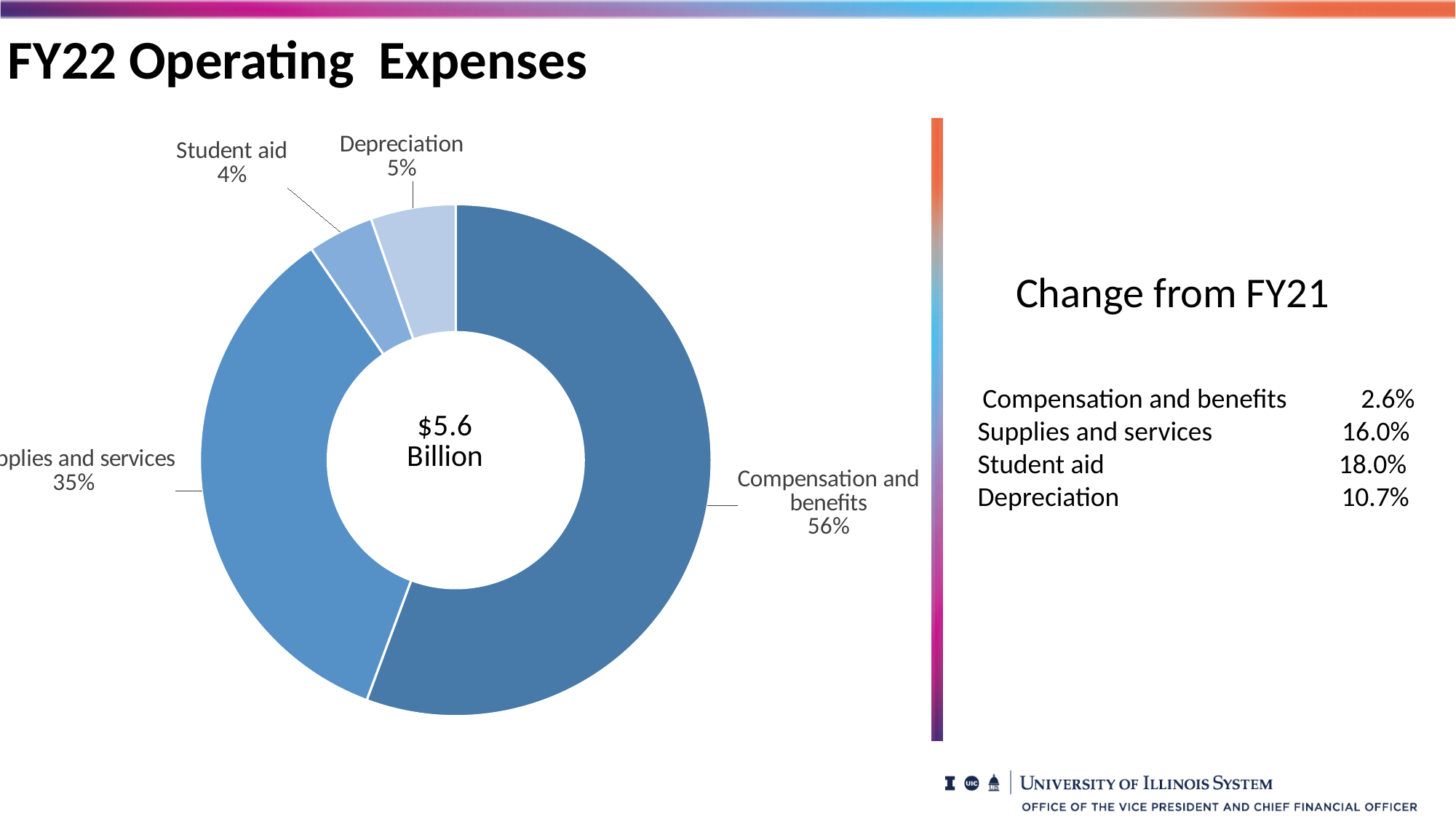
What share of FY22 operating expenses is Compensation and benefits? 56% What share of FY22 operating expenses is Supplies and services? 35% What total amount is shown in the center of the donut chart? $5.6 Billion How many categories are shown in the donut chart? 4 Which is larger, the Depreciation share or the Student aid share? Depreciation How many percentage points larger is the Compensation and benefits share than the Supplies and services share? 21 Which category has the largest share of FY22 operating expenses? Compensation and benefits What percentage of the donut chart is Depreciation? 5% Which category has the smallest share of FY22 operating expenses? Student aid What kind of chart is used to show FY22 operating expenses? Donut (pie) chart What is the title of the slide containing the chart? FY22 Operating Expenses What percentage of the donut chart is Student aid? 4%